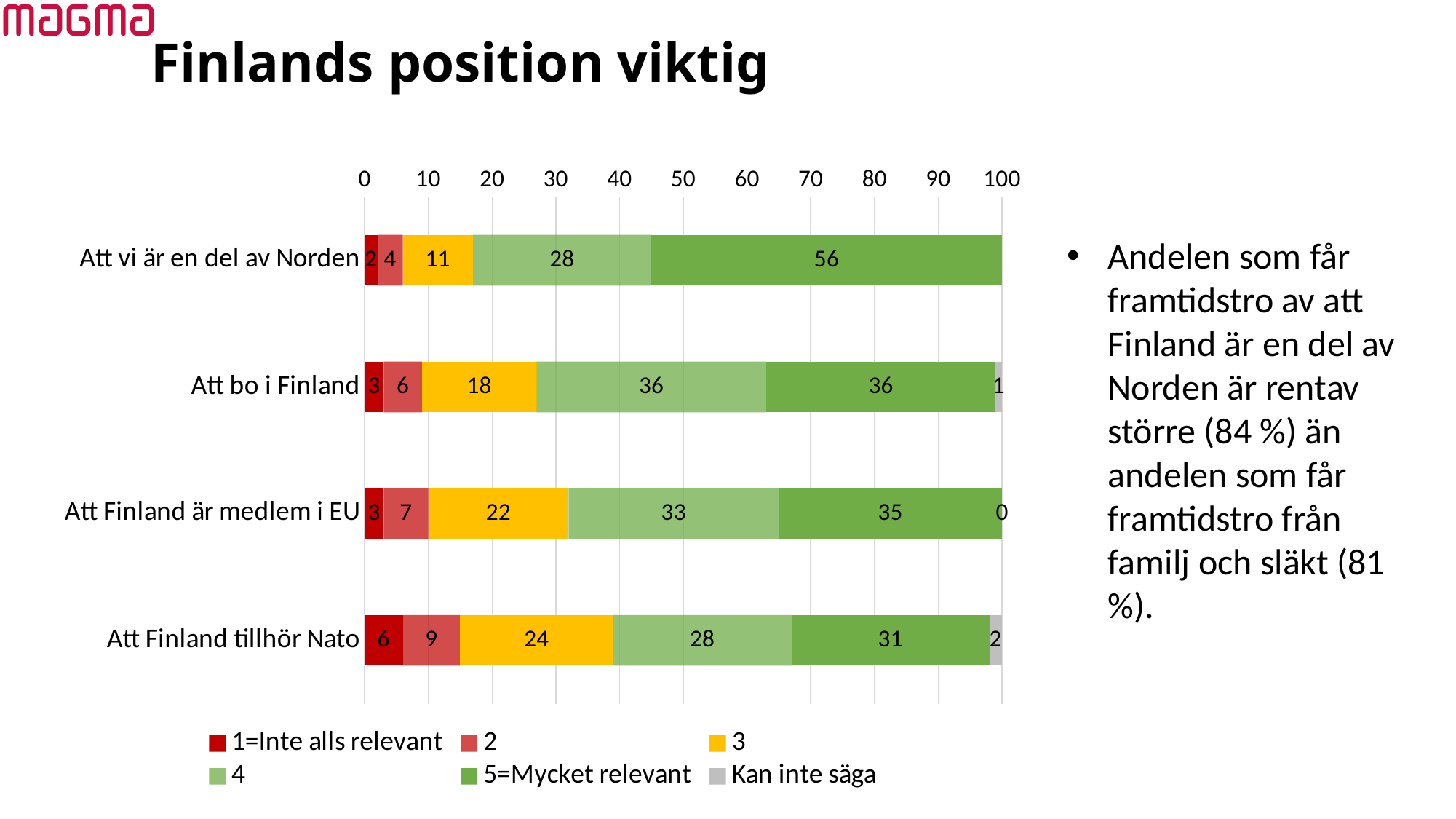
Which has the larger value for series "4": "Att bo i Finland" or "Att Finland är medlem i EU"? Att bo i Finland Which category has the highest value for "1=Inte alls relevant"? Att Finland tillhör Nato How many series does the legend list? 6 How many categories are shown in the chart? 4 Which category has the highest value for "5=Mycket relevant"? Att vi är en del av Norden What is the difference between the "5=Mycket relevant" values for "Att vi är en del av Norden" and "Att Finland tillhör Nato"? 25 Which category has the lowest value for "1=Inte alls relevant"? Att vi är en del av Norden What is the value for "5=Mycket relevant" in the "Att vi är en del av Norden" bar? 56 What is the value for series "3" in the "Att Finland tillhör Nato" bar? 24 What kind of chart is shown on the slide? Stacked bar chart What is the value for "Kan inte säga" in the "Att bo i Finland" bar? 1 What is the total of the stacked bar for "Att Finland tillhör Nato"? 100